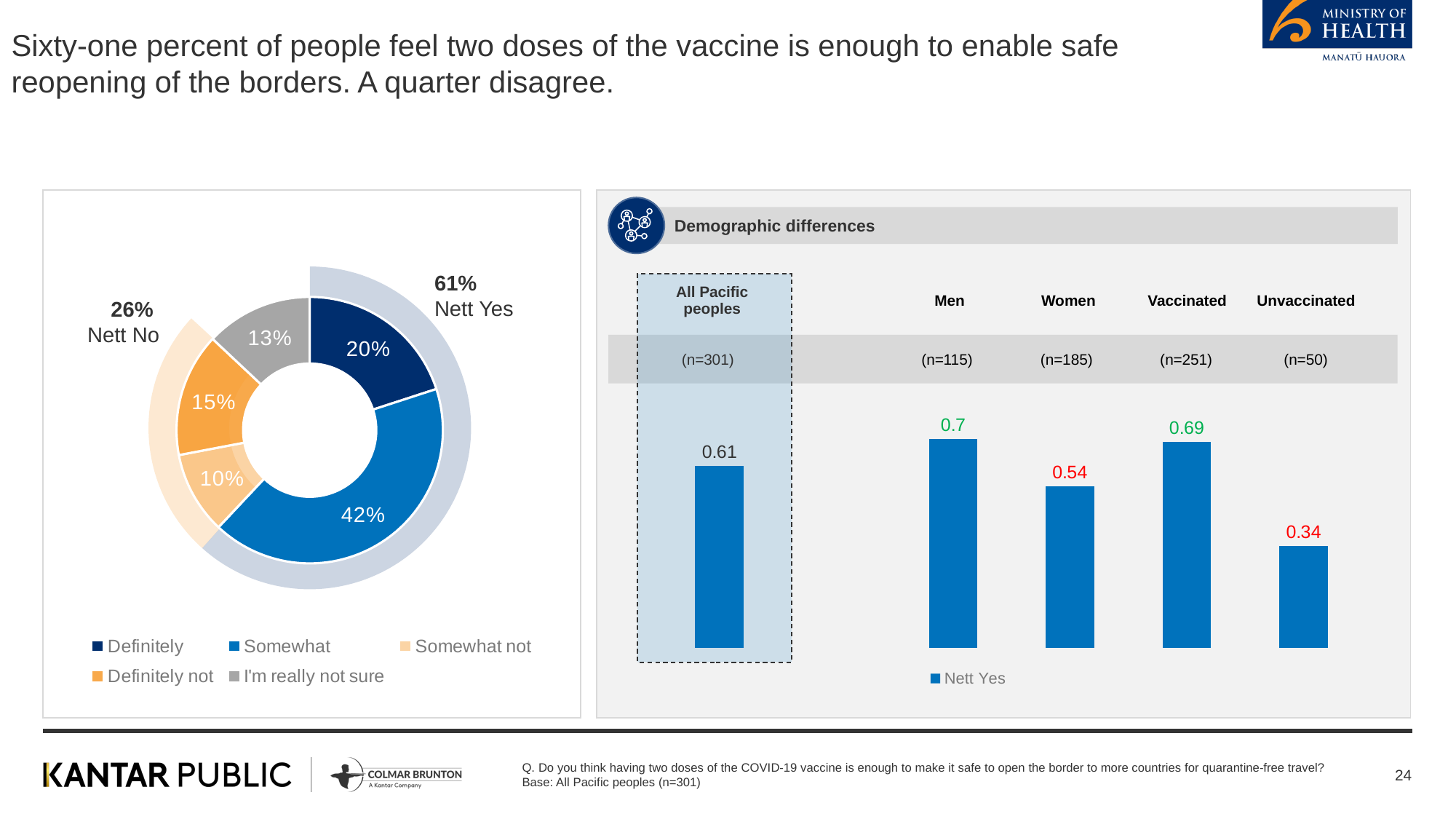
In the donut chart on the left, what is the difference between the 'Definitely' and 'Definitely not' shares? 5% In the donut chart on the left, what percentage of people answered 'Definitely not'? 15% In the donut chart on the left, which response category has the smallest share? Somewhat not In the 'Demographic differences' bar chart, is the Nett Yes value for Men or Women larger? Men What type of chart is the 'Demographic differences' chart on the right? Bar chart In the donut chart on the left, how many response categories does the legend list? 5 In the donut chart on the left, what percentage of people answered 'Somewhat'? 42% In the donut chart on the left, which response category has the largest share? Somewhat In the donut chart on the left, what is the Nett No percentage shown? 26% In the 'Demographic differences' bar chart, which group has the lowest Nett Yes value? Unvaccinated In the 'Demographic differences' bar chart, what is the difference between the Vaccinated and Unvaccinated Nett Yes values? 0.35 In the 'Demographic differences' bar chart, what is the Nett Yes value for Men? 0.7